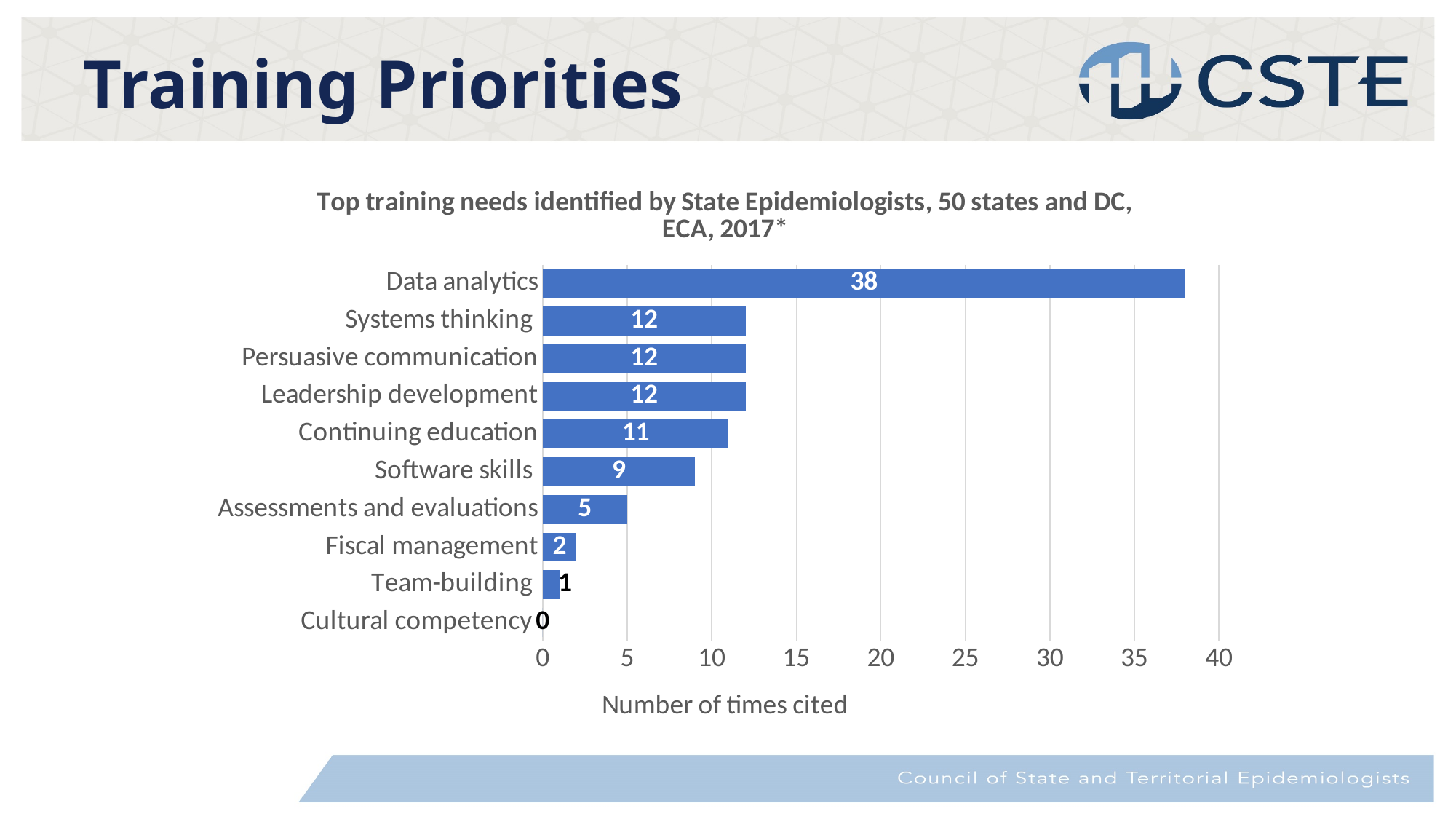
What is the value for Software skills? 9 Which training need was cited the most times? Data analytics Which was cited more often, Software skills or Assessments and evaluations? Software skills How many training needs are listed in the chart? 10 How many times was Continuing education cited? 11 What is the label of the horizontal axis? Number of times cited How many times was Data analytics cited as a training need? 38 What is the difference between the number of times Data analytics and Systems thinking were cited? 26 What is the difference between Assessments and evaluations and Fiscal management? 3 What type of chart is shown on the slide? Bar chart Which training need was cited the fewest times? Cultural competency What is the title of the chart? Top training needs identified by State Epidemiologists, 50 states and DC, ECA, 2017*